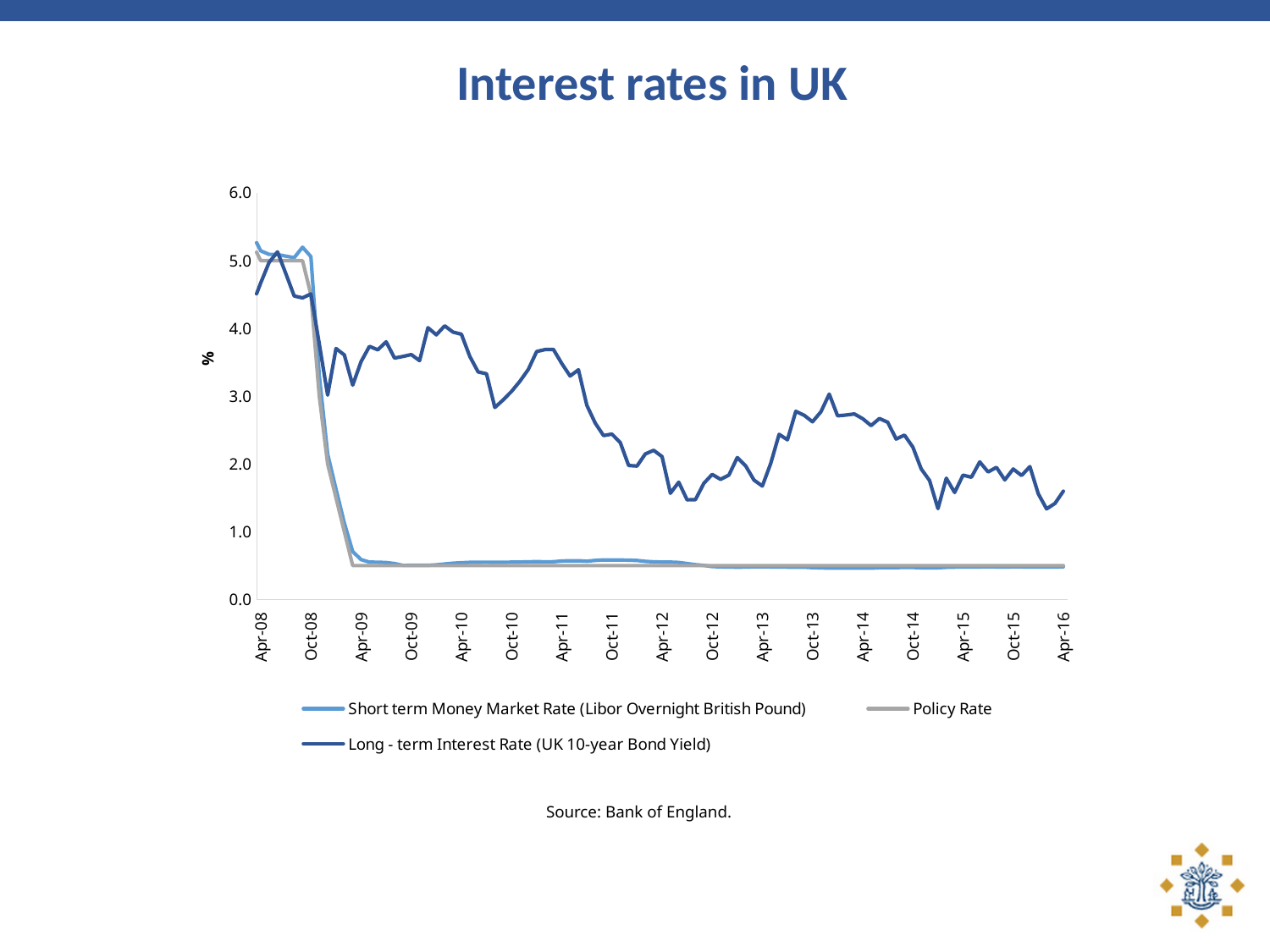
Does the Policy Rate rise or fall between Apr-08 and Apr-16? fall Is the Long - term Interest Rate (UK 10-year Bond Yield) at Oct-13 greater or less than 2.0? greater What kind of chart is shown on the slide? Line chart What is the title of the chart? Interest rates in UK Is the Long - term Interest Rate (UK 10-year Bond Yield) at Apr-08 greater or less than 4.0? greater How many series does the legend list? 3 Is the Policy Rate at Apr-16 greater or less than 1.0? less At Apr-16, which is larger: the Long - term Interest Rate (UK 10-year Bond Yield) or the Policy Rate? Long - term Interest Rate (UK 10-year Bond Yield) At Oct-09, which is larger: the Long - term Interest Rate (UK 10-year Bond Yield) or the Short term Money Market Rate (Libor Overnight British Pound)? Long - term Interest Rate (UK 10-year Bond Yield) What is the label on the y axis? % How many date labels are shown on the x axis? 17